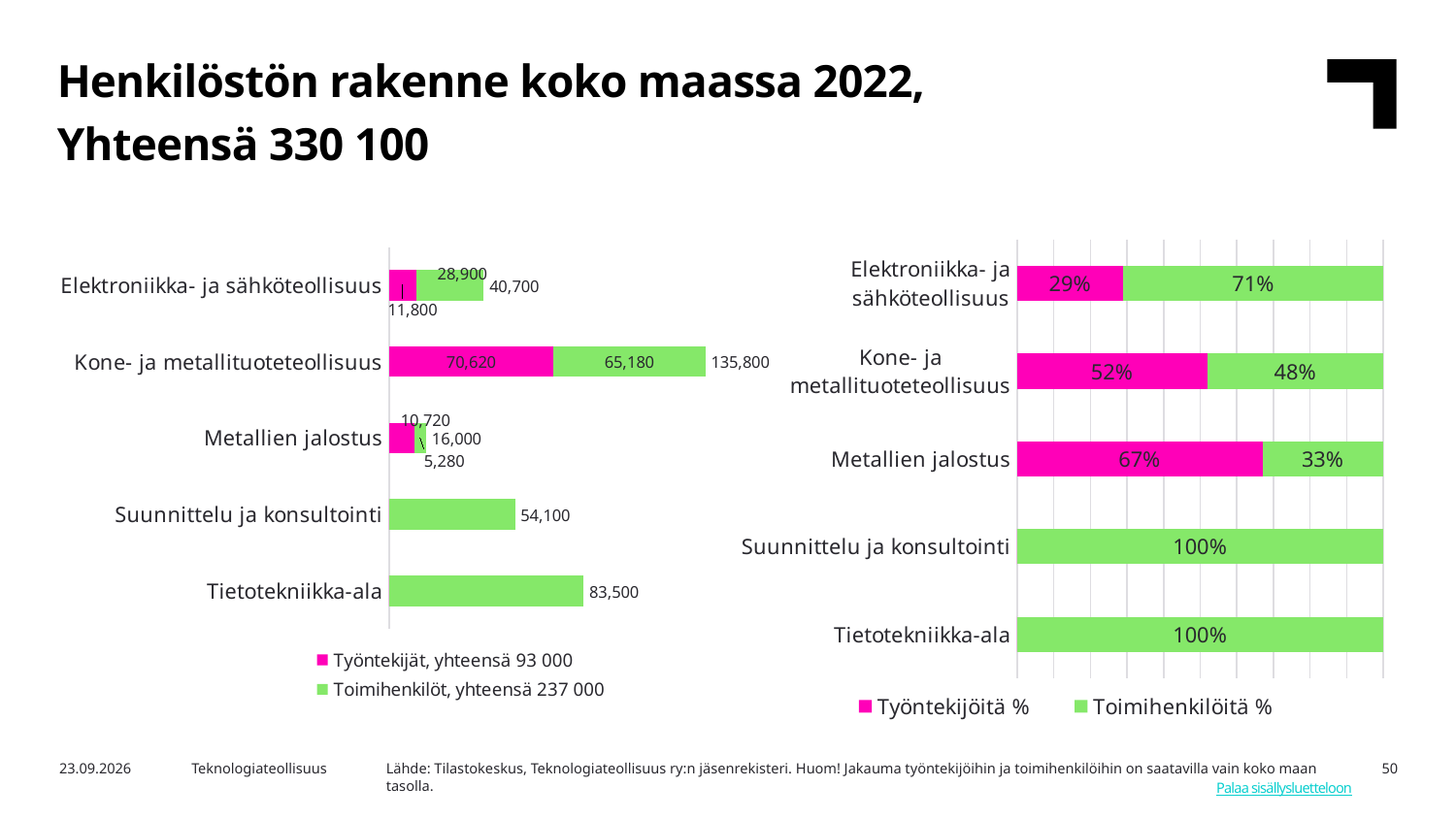
In the left chart, what is the Toimihenkilöt value for Tietotekniikka-ala? 83,500 In the left chart, what is the Toimihenkilöt value for Metallien jalostus? 5,280 What type of chart is the right chart? Bar chart In the left chart, what is the difference between the Työntekijät and Toimihenkilöt values for Kone- ja metallituoteteollisuus? 5,440 In the right chart, what is the Toimihenkilöitä % value for Elektroniikka- ja sähköteollisuus? 71% In the left chart, which category has the lowest total value? Metallien jalostus In the right chart, what is the Työntekijöitä % value for Metallien jalostus? 67% In the left chart, how many series does the legend list? 2 In the left chart, which category has the highest total value? Kone- ja metallituoteteollisuus In the right chart, which is larger for Kone- ja metallituoteteollisuus: Työntekijöitä % or Toimihenkilöitä %? Työntekijöitä % In the left chart, what is the Työntekijät value for Elektroniikka- ja sähköteollisuus? 11,800 In the left chart, what is the total value shown for Kone- ja metallituoteteollisuus? 135,800